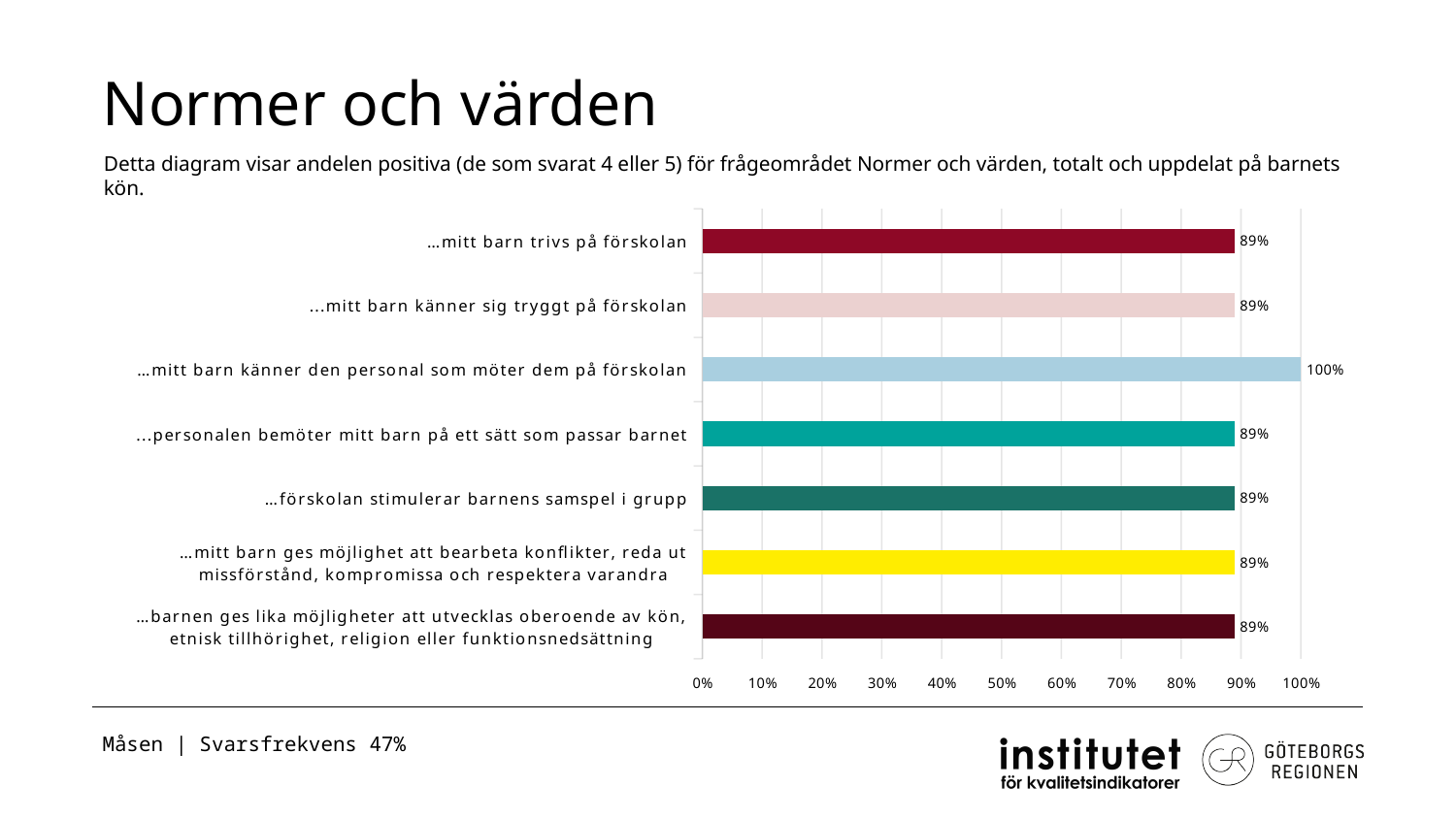
How many categories are shown in the chart? 7 What kind of chart is shown on the slide? bar chart Is the value for "…mitt barn känner sig tryggt på förskolan" greater or less than 80%? greater What is the difference between the value for "…mitt barn känner den personal som möter dem på förskolan" and the value for "…mitt barn trivs på förskolan"? 11% What is the maximum value shown on the x axis? 100% What is the value for "…mitt barn trivs på förskolan"? 89% What is the value for "…mitt barn känner den personal som möter dem på förskolan"? 100% Which is larger: the value for "…mitt barn känner den personal som möter dem på förskolan" or the value for "…personalen bemöter mitt barn på ett sätt som passar barnet"? …mitt barn känner den personal som möter dem på förskolan Which category has the highest value? …mitt barn känner den personal som möter dem på förskolan What is the value for "…förskolan stimulerar barnens samspel i grupp"? 89% What is the title of the slide? Normer och värden What is the value for "…barnen ges lika möjligheter att utvecklas oberoende av kön, etnisk tillhörighet, religion eller funktionsnedsättning"? 89%